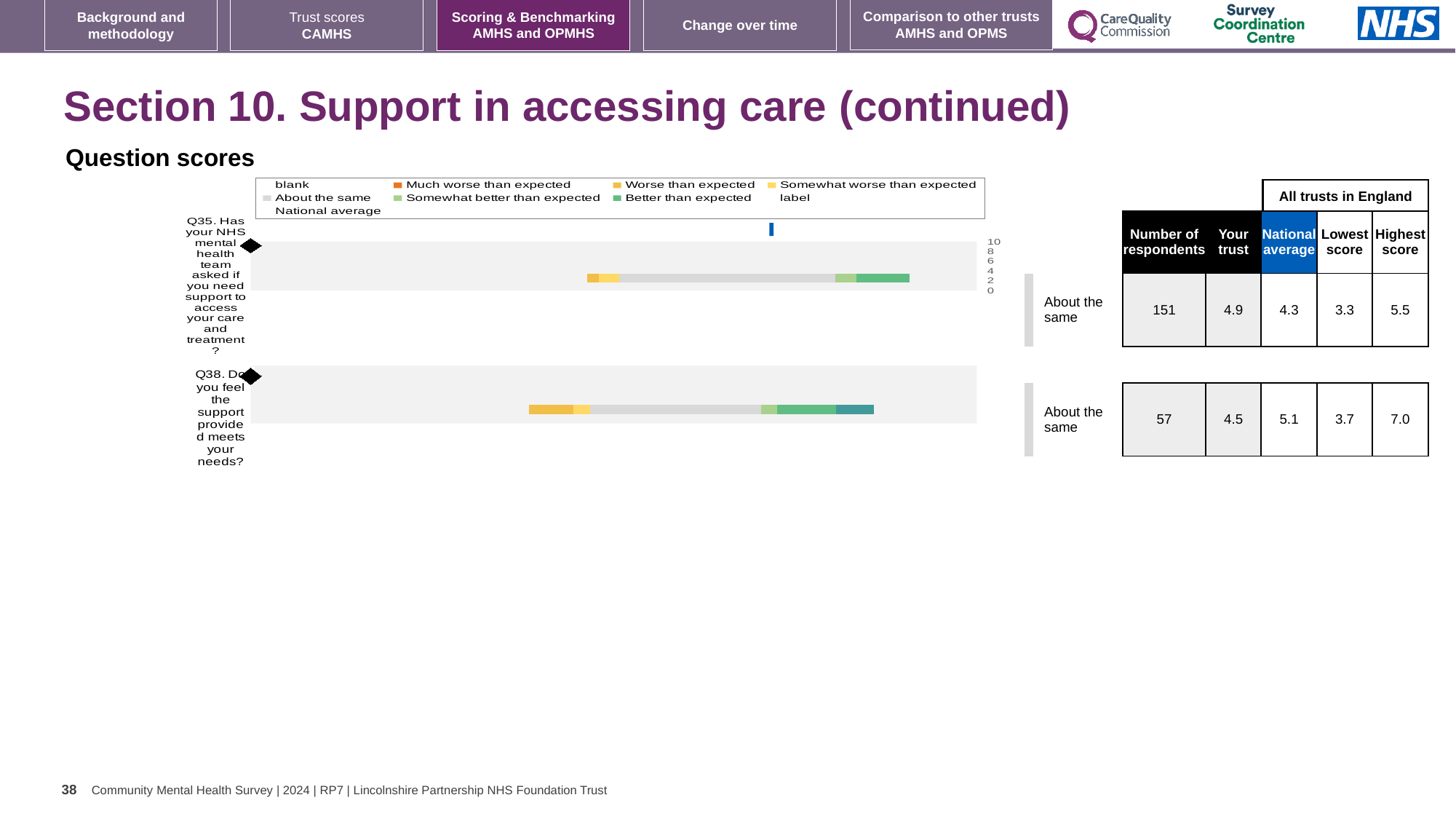
According to the table beside the chart, what is the 'Your trust' score for Q35? 4.9 Which question has the higher 'Your trust' score, Q35 or Q38? Q35 How many questions (categories) are plotted in the chart? 2 What benchmark category is shown for both Q35 and Q38? About the same What is the difference between the highest score and the lowest score for Q38? 3.3 For Q38, is the trust's score higher or lower than the national average? lower According to the table beside the chart, what is the 'Your trust' score for Q38? 4.5 What is the national average score for Q38? 5.1 What is the difference between the highest score and the lowest score for Q35? 2.2 What is the national average score for Q35? 4.3 What kind of chart is shown under 'Question scores'? bar chart How many respondents answered Q35? 151